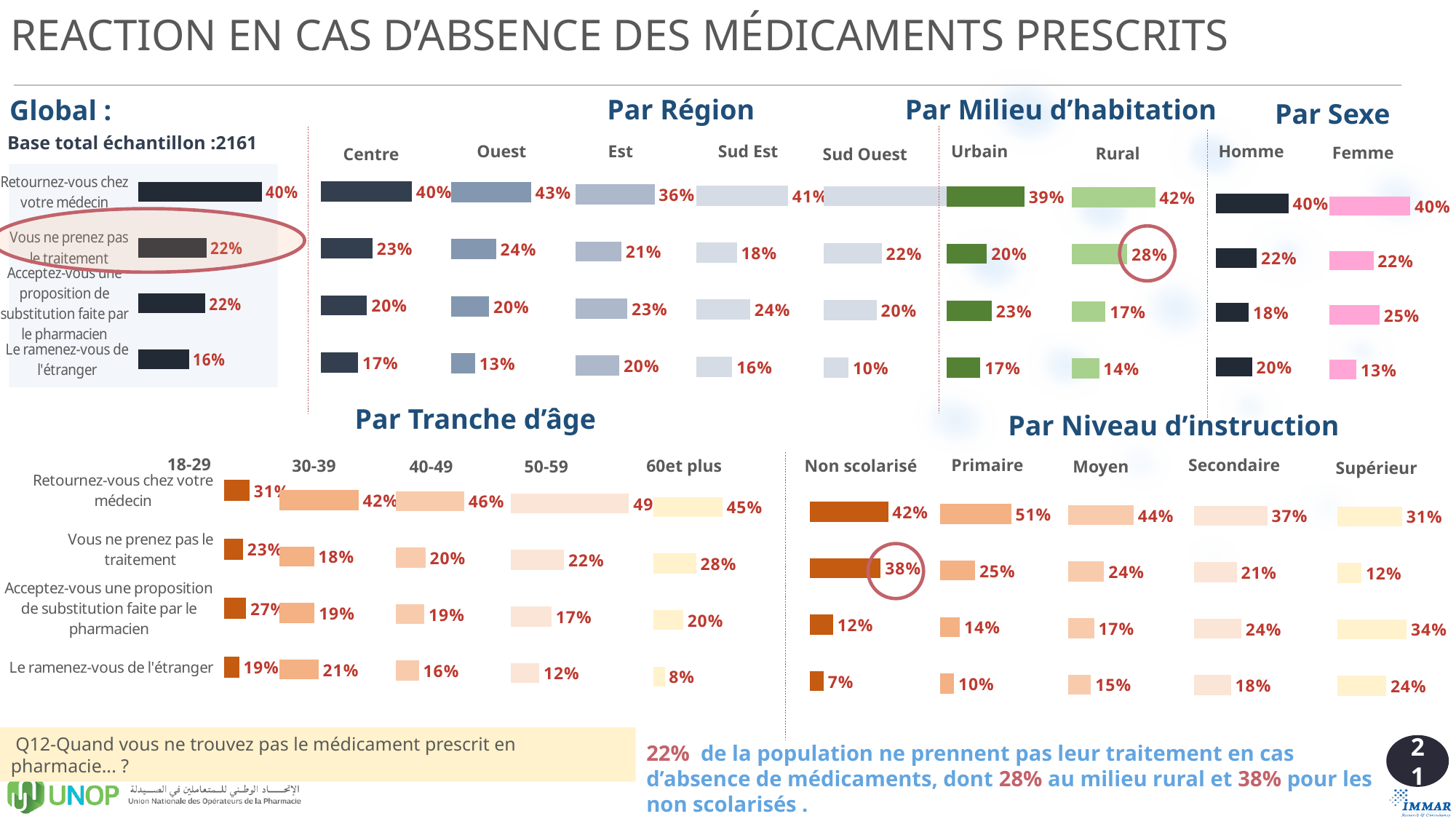
In the Par Niveau d'instruction chart, what is the Non scolarisé value for 'Vous ne prenez pas le traitement'? 38% What type of chart is used on this slide to show the results? Bar chart In the Par Région chart, which region has the highest value for 'Le ramenez-vous de l'étranger'? Est In the Par Niveau d'instruction chart, which education level has the highest value for 'Retournez-vous chez votre médecin'? Primaire In the Global chart, which response has the lowest percentage? Le ramenez-vous de l'étranger In the Par Milieu d'habitation chart, what is the Rural value for 'Vous ne prenez pas le traitement'? 28% In the Par Sexe chart, which is larger for 'Acceptez-vous une proposition de substitution faite par le pharmacien': Homme or Femme? Femme In the Par Région chart, what is the Ouest value for 'Retournez-vous chez votre médecin'? 43% In the Par Tranche d'âge chart, what is the 60et plus value for 'Le ramenez-vous de l'étranger'? 8% In the Global chart, what percentage of respondents say they return to their doctor (Retournez-vous chez votre médecin)? 40% In the Par Milieu d'habitation chart, what is the difference between the Rural and Urbain values for 'Vous ne prenez pas le traitement'? 8 percentage points In the Global chart, how many response categories are shown? 4